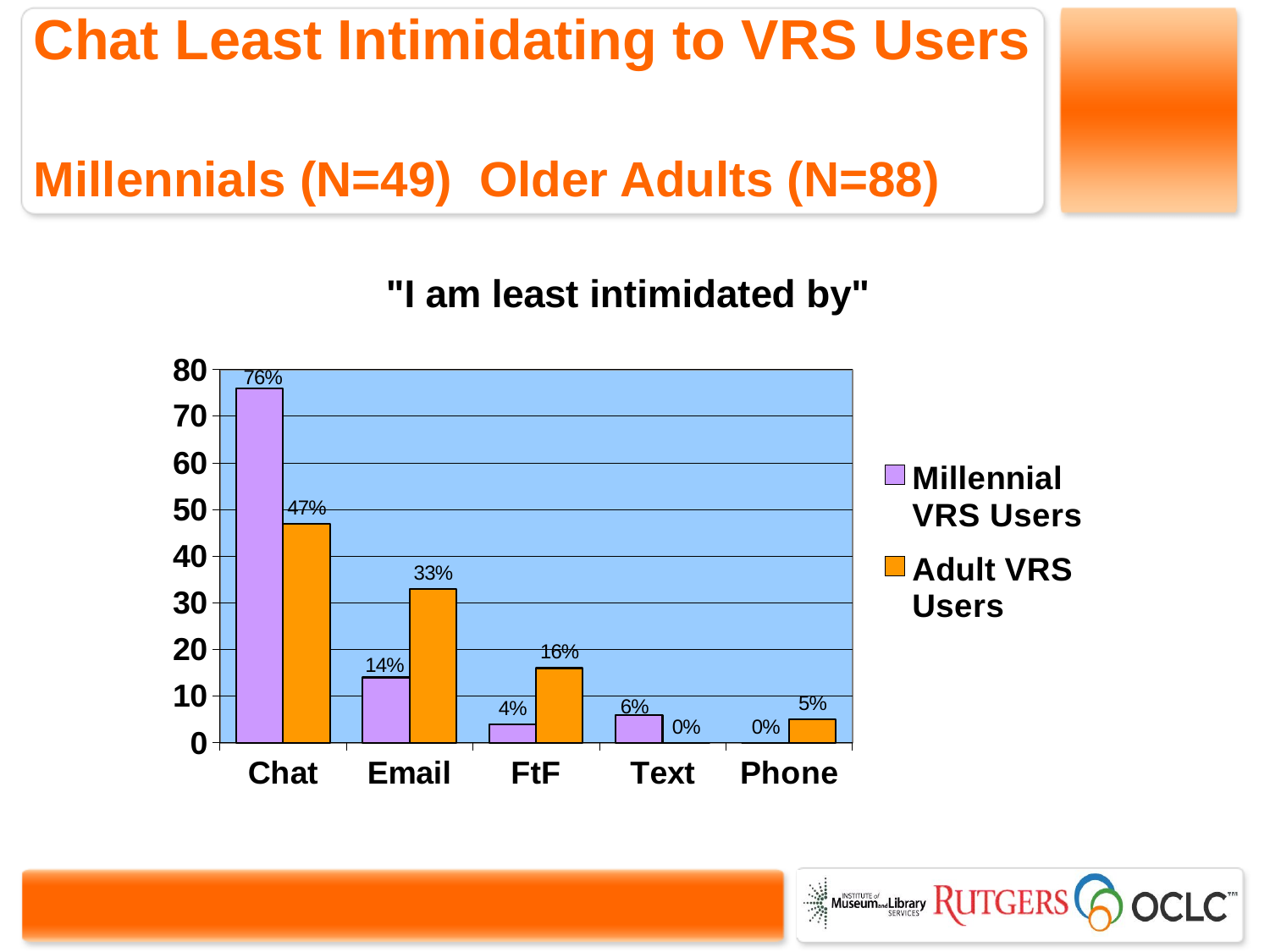
Which is larger for Email: Millennial VRS Users or Adult VRS Users? Adult VRS Users Which category has the lowest value for Millennial VRS Users? Phone How many series does the legend list? 2 What is the value for Adult VRS Users for Email? 33% What is the value for Millennial VRS Users for FtF? 4% What is the value for Millennial VRS Users for Chat? 76% Which category has the highest value for Adult VRS Users? Chat What kind of chart is shown? Bar chart What is the value for Adult VRS Users for Phone? 5% How many categories are shown on the x axis? 5 What is the difference between Millennial VRS Users and Adult VRS Users for Chat? 29% What is the title of the chart? "I am least intimidated by"